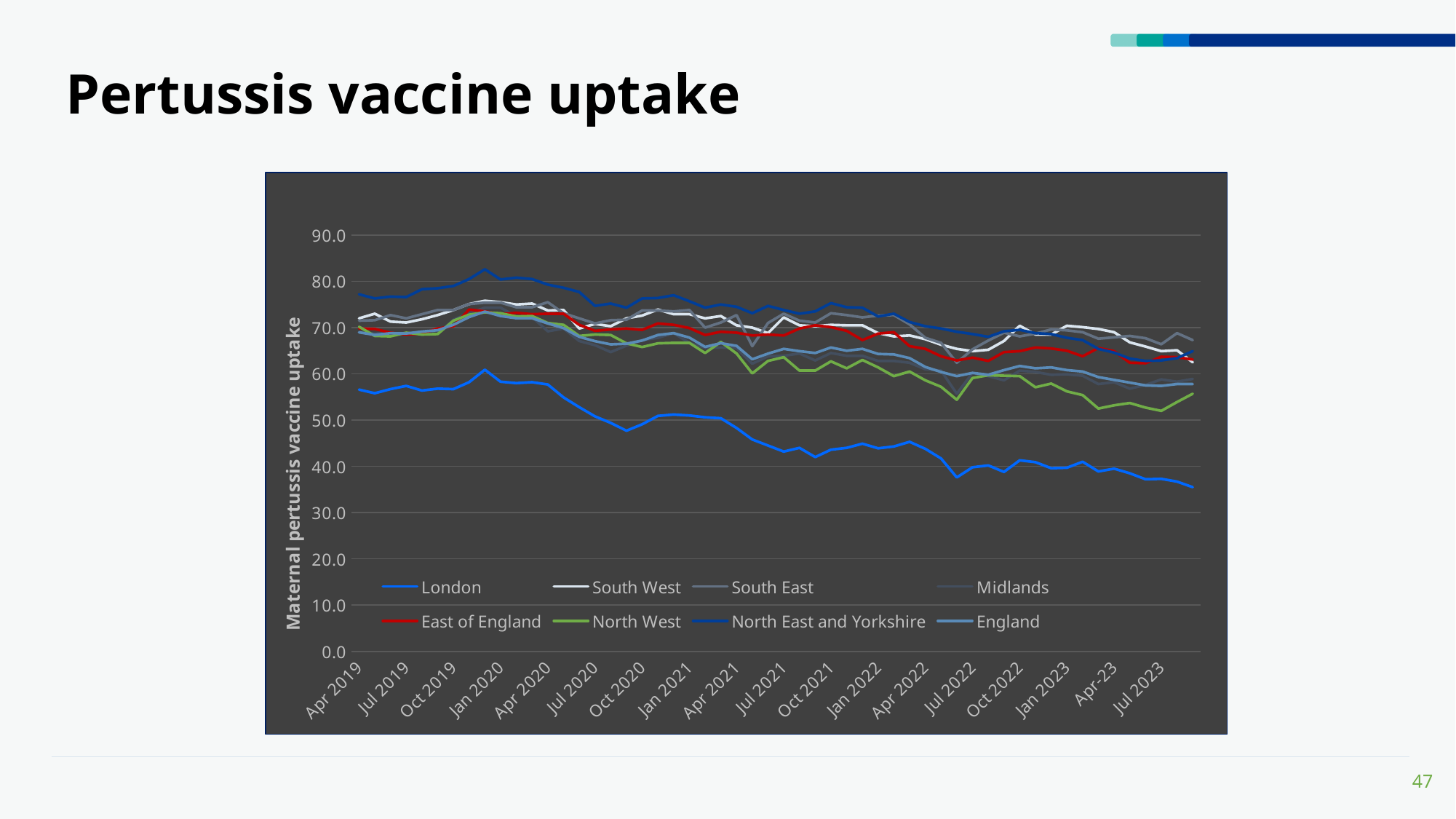
What is the title of the vertical axis? Maternal pertussis vaccine uptake Is the value for London at Apr 2019 greater or less than 50.0? greater Does the England series rise or fall from Apr 2019 to Jul 2023? fall Which series has the lowest values across the whole period? London Which series has the highest value at Apr 2019? North East and Yorkshire Is the value for North East and Yorkshire at Jan 2020 greater or less than 70.0? greater How many series does the legend list? 8 Does the London series rise or fall from Apr 2019 to Jul 2023? fall What kind of chart is shown on the slide? line chart Which series is drawn in red? East of England Is the value for London at Jul 2023 greater or less than 40.0? less